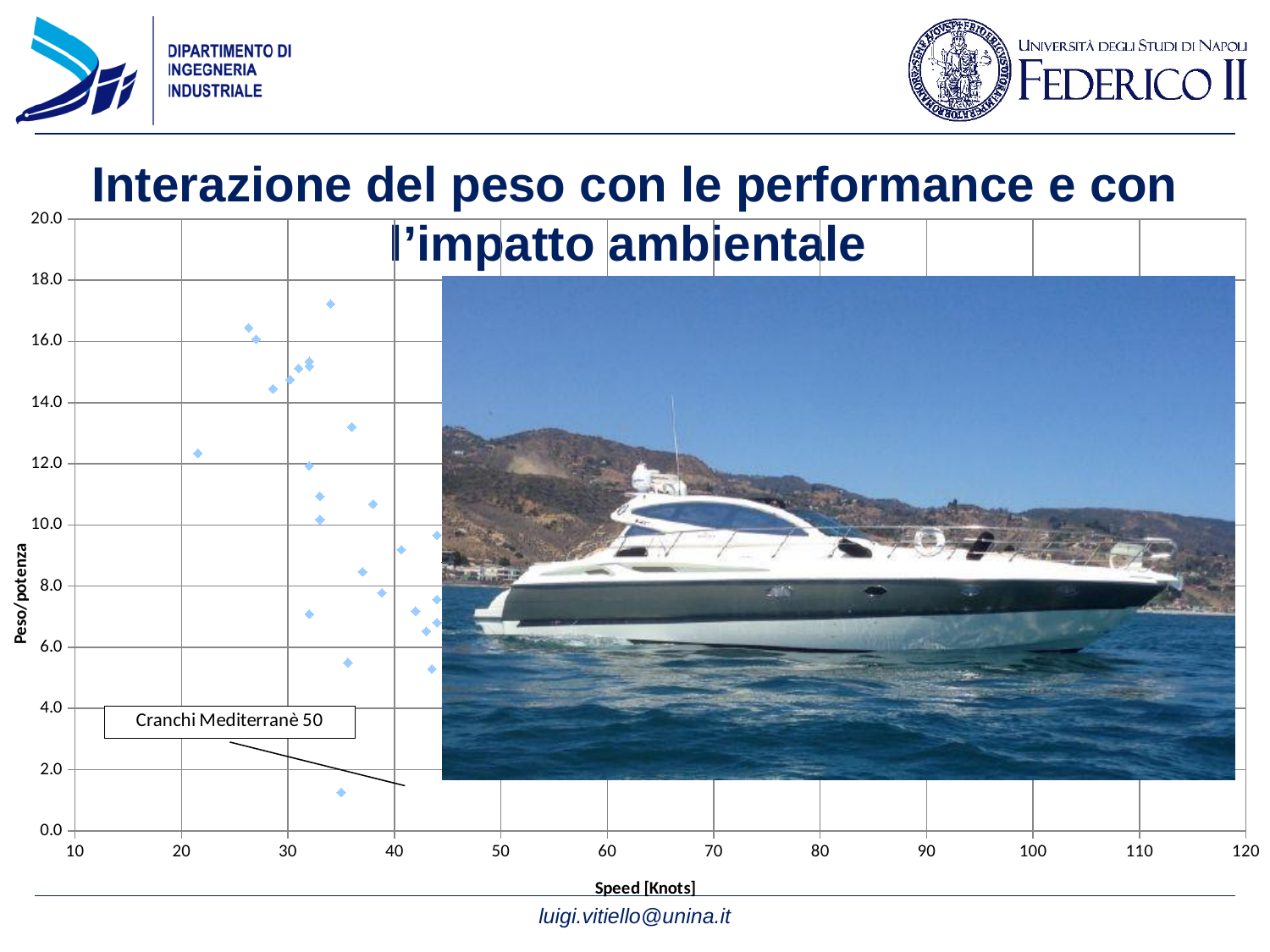
What is the title of the y axis of the chart? Peso/potenza What kind of chart is shown on the slide? scatter chart What is the title of the x axis of the chart? Speed [Knots] Is the speed of the point labelled Cranchi Mediterranè 50 greater or less than 30 knots? greater Is the Peso/potenza value for the point labelled Cranchi Mediterranè 50 greater or less than 2.0? less Is the Peso/potenza value for the point labelled Cranchi Mediterranè 50 greater or less than 4.0? less